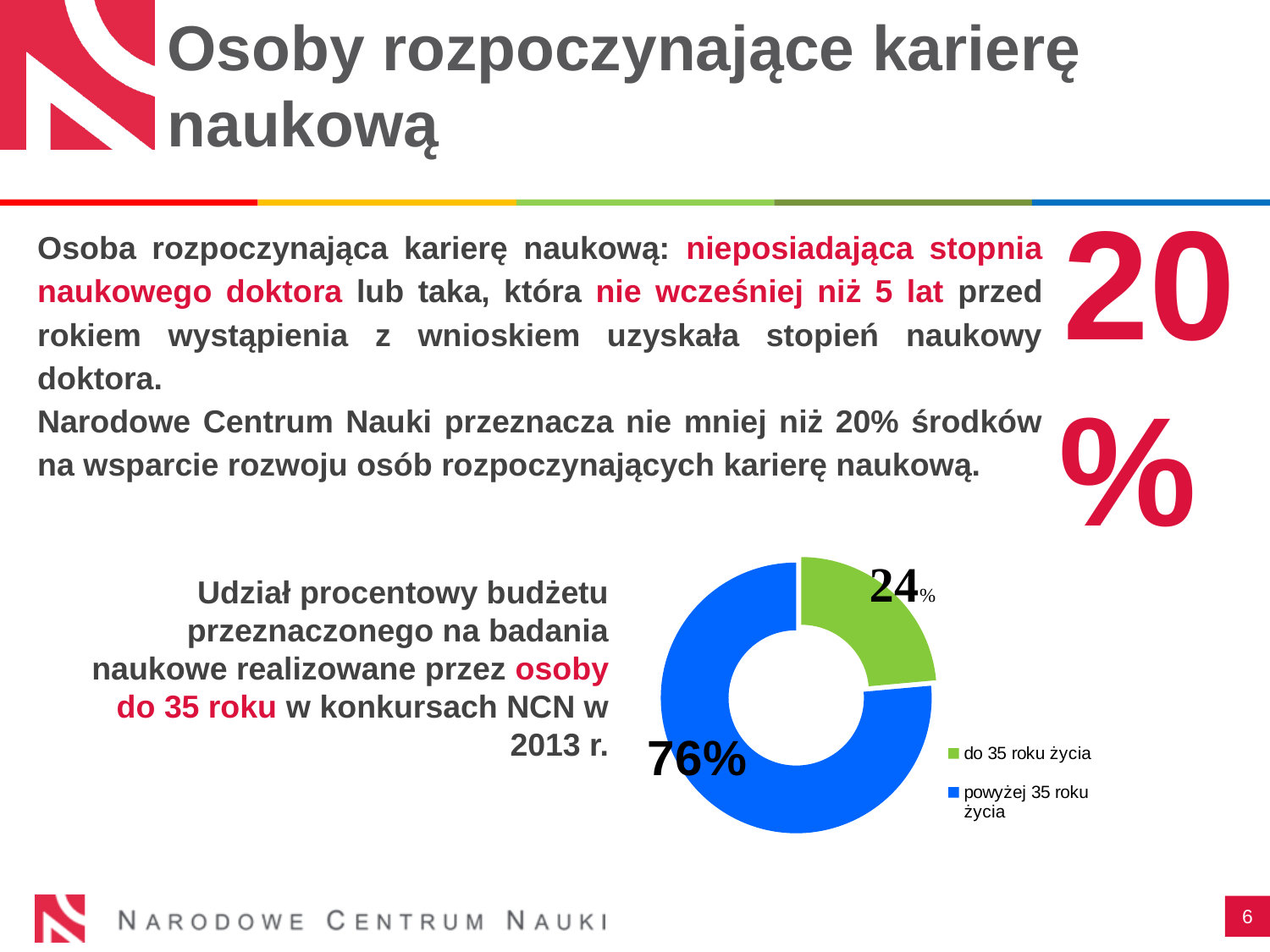
Which category has the largest share of the chart? powyżej 35 roku życia What is the total of the two slices shown in the chart? 100% How many categories does the chart show? 2 Which is larger: the share for 'do 35 roku życia' or for 'powyżej 35 roku życia'? powyżej 35 roku życia What kind of chart is shown on the slide? Doughnut (pie) chart Which category has the smallest share of the chart? do 35 roku życia What share of the budget goes to 'powyżej 35 roku życia'? 76% What share of the budget goes to 'do 35 roku życia'? 24% What colour is the slice for 'powyżej 35 roku życia'? Blue How many entries does the legend list? 2 What colour is the slice for 'do 35 roku życia'? Green What is the difference in percentage points between 'powyżej 35 roku życia' and 'do 35 roku życia'? 52